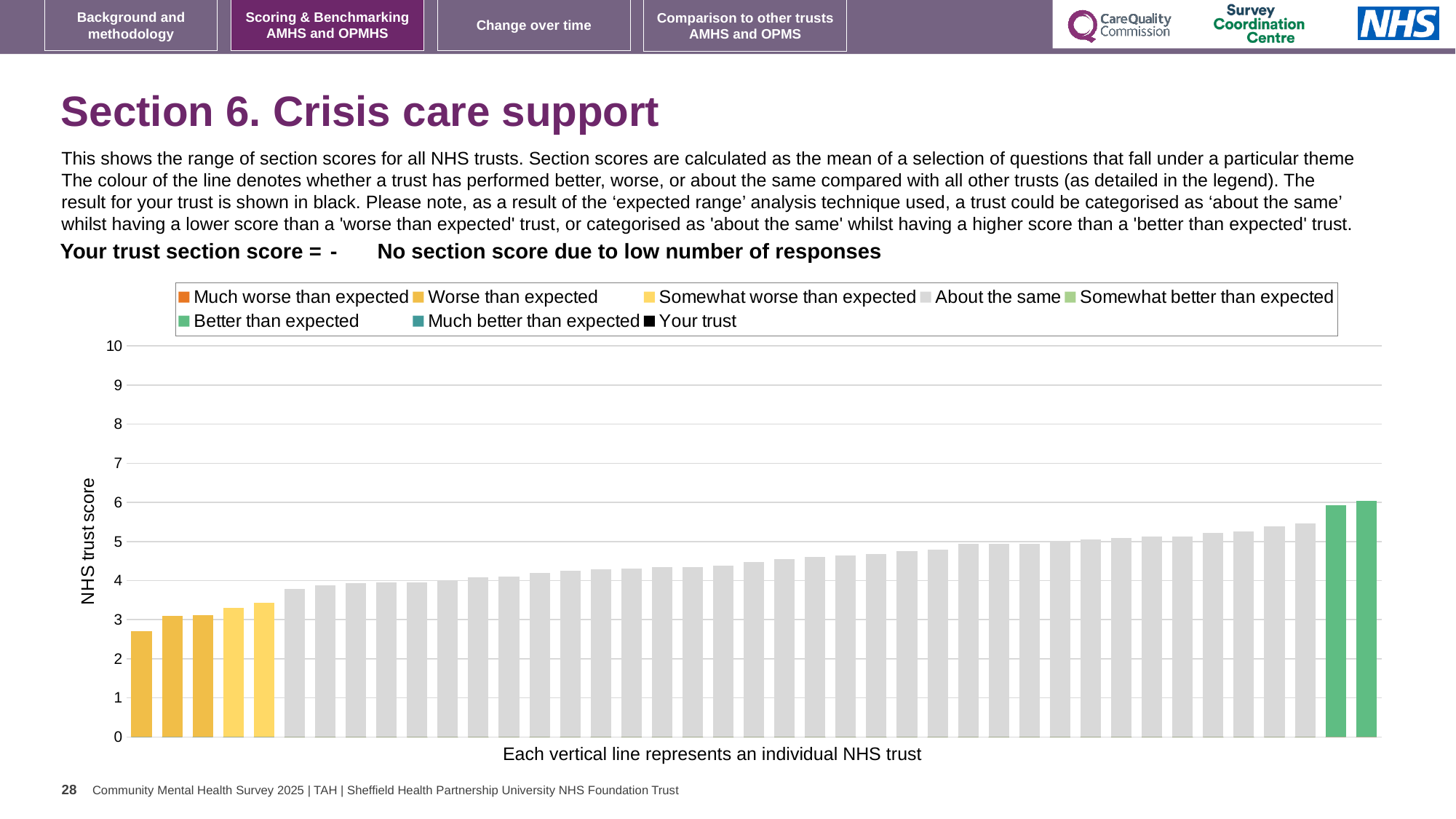
Which bar is taller, the leftmost bar or the rightmost bar? the rightmost bar How many bars are coloured green (better than expected)? 2 Is the value of the tallest bar greater or less than 5? greater How many entries does the chart legend list? 8 Is the value of the leftmost grey bar greater or less than 4? less What type of chart is shown on the slide? bar chart How many bars are coloured yellow (worse or somewhat worse than expected)? 5 Is the value of the shortest (leftmost) bar greater or less than 3? less Do the bar values rise or fall from left to right along the x axis? rise What is the label on the vertical axis of the chart? NHS trust score What is given as the trust's section score above the chart? - (No section score due to low number of responses)